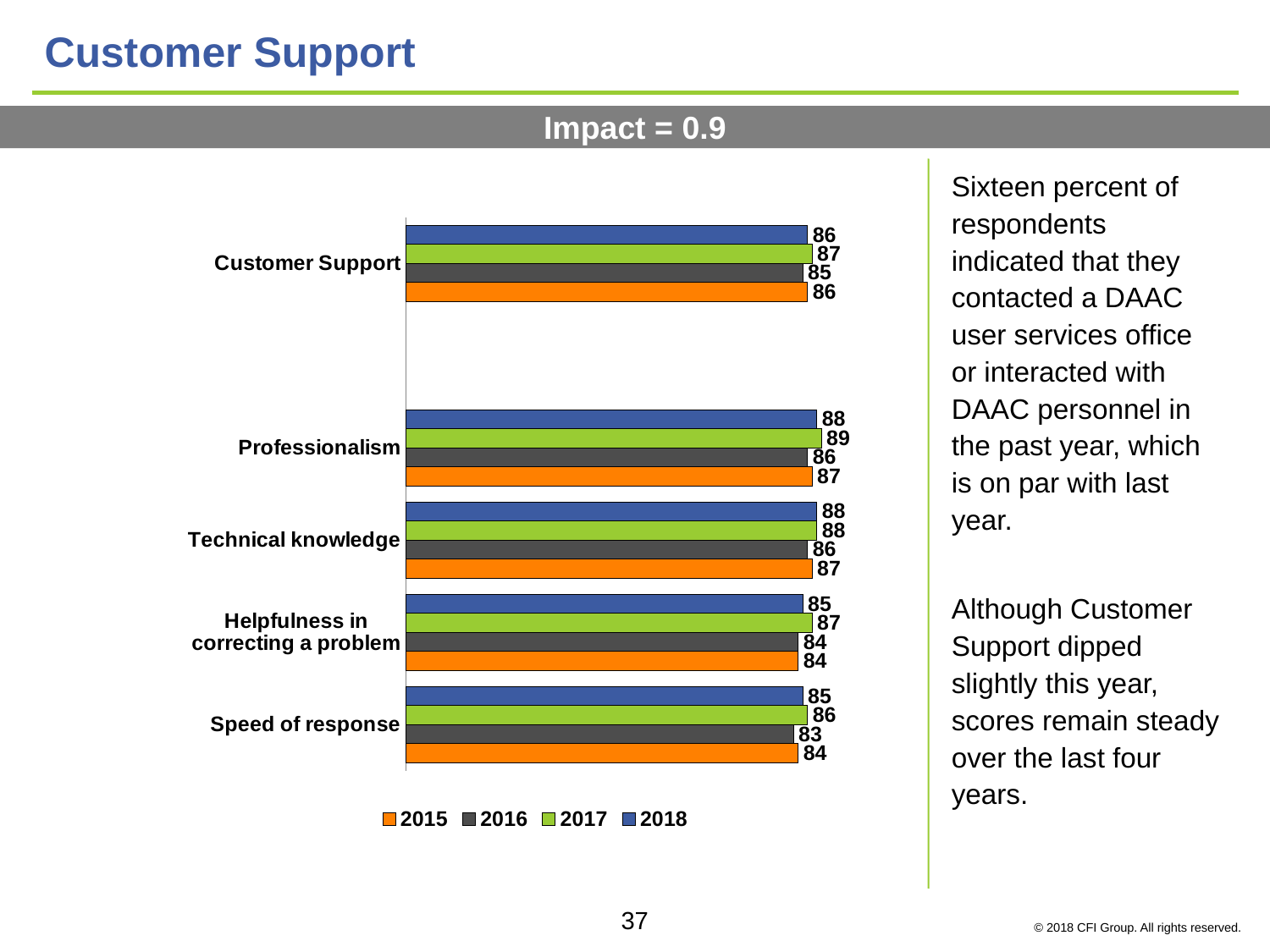
How many categories are shown on the chart? 5 Which is larger for Technical knowledge, the 2015 value or the 2016 value? 2015 What is the 2015 value for Customer Support? 86 Which category has the highest 2017 value? Professionalism What kind of chart is shown on the slide? Bar chart How many series does the legend list? 4 Which category has the lowest 2016 value? Speed of response What is the 2017 value for Helpfulness in correcting a problem? 87 Which colour represents the 2015 series in the legend? Orange What is the 2018 value for Professionalism? 88 What is the difference between the 2017 and 2016 values for Speed of response? 3 What is the 2016 value for Speed of response? 83